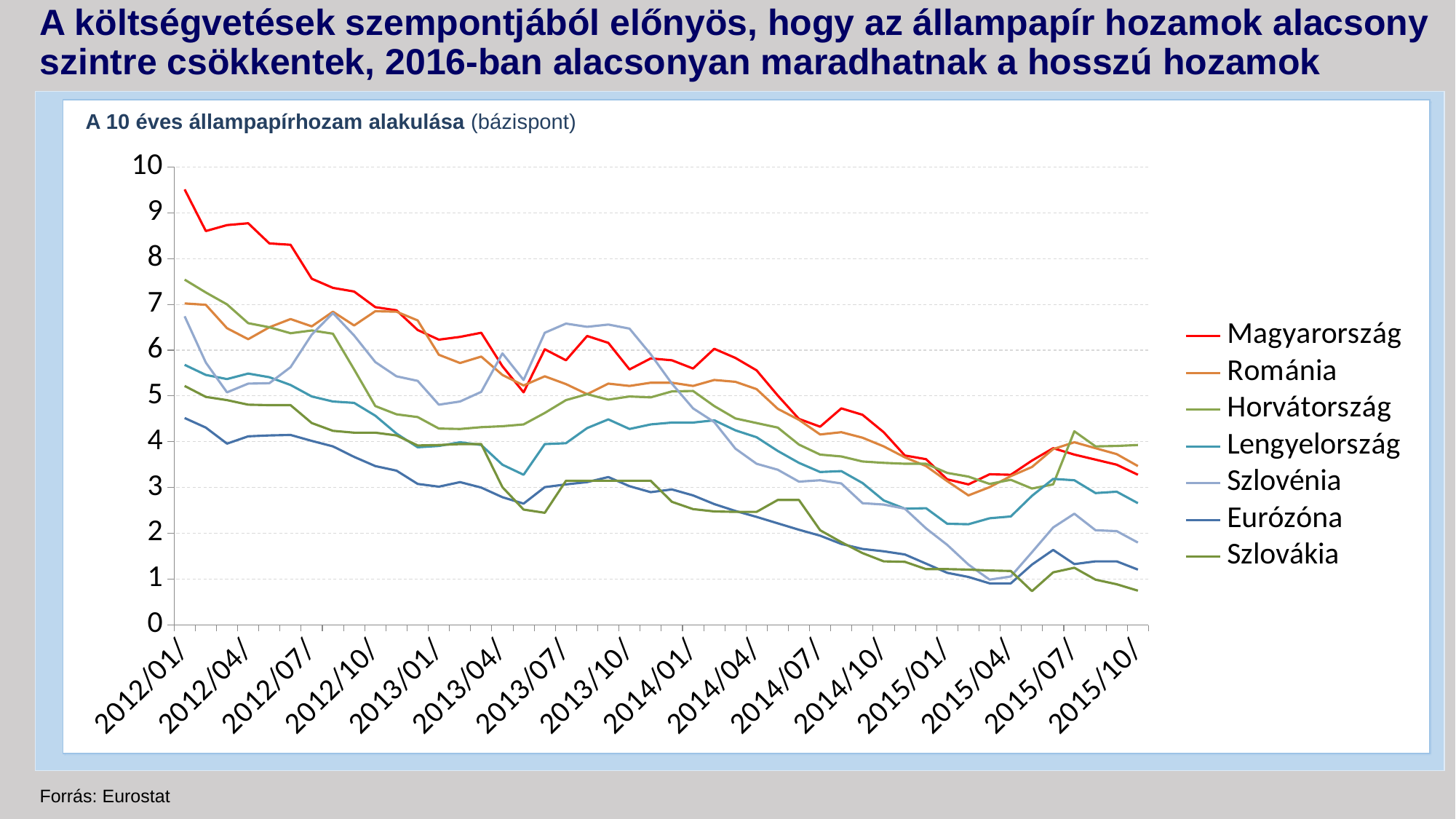
What is the title of the chart? A 10 éves állampapírhozam alakulása (bázispont) Does the Magyarország series generally rise or fall from 2012/01 to 2015/10? fall What kind of chart is shown on the slide? line chart What colour is the line for Magyarország? red Which series has the highest value at 2012/01? Magyarország Is the value for Eurózóna at 2015/10 greater or less than 2? less Which series has the lowest value at 2012/01? Eurózóna Which series has the lowest value at 2015/10? Szlovákia How many series does the legend list? 7 At 2015/10, which is larger: the value for Magyarország or the value for Eurózóna? Magyarország Is the value for Szlovénia at 2013/10 greater or less than 6? greater Is the value for Magyarország at 2012/01 greater or less than 9? greater